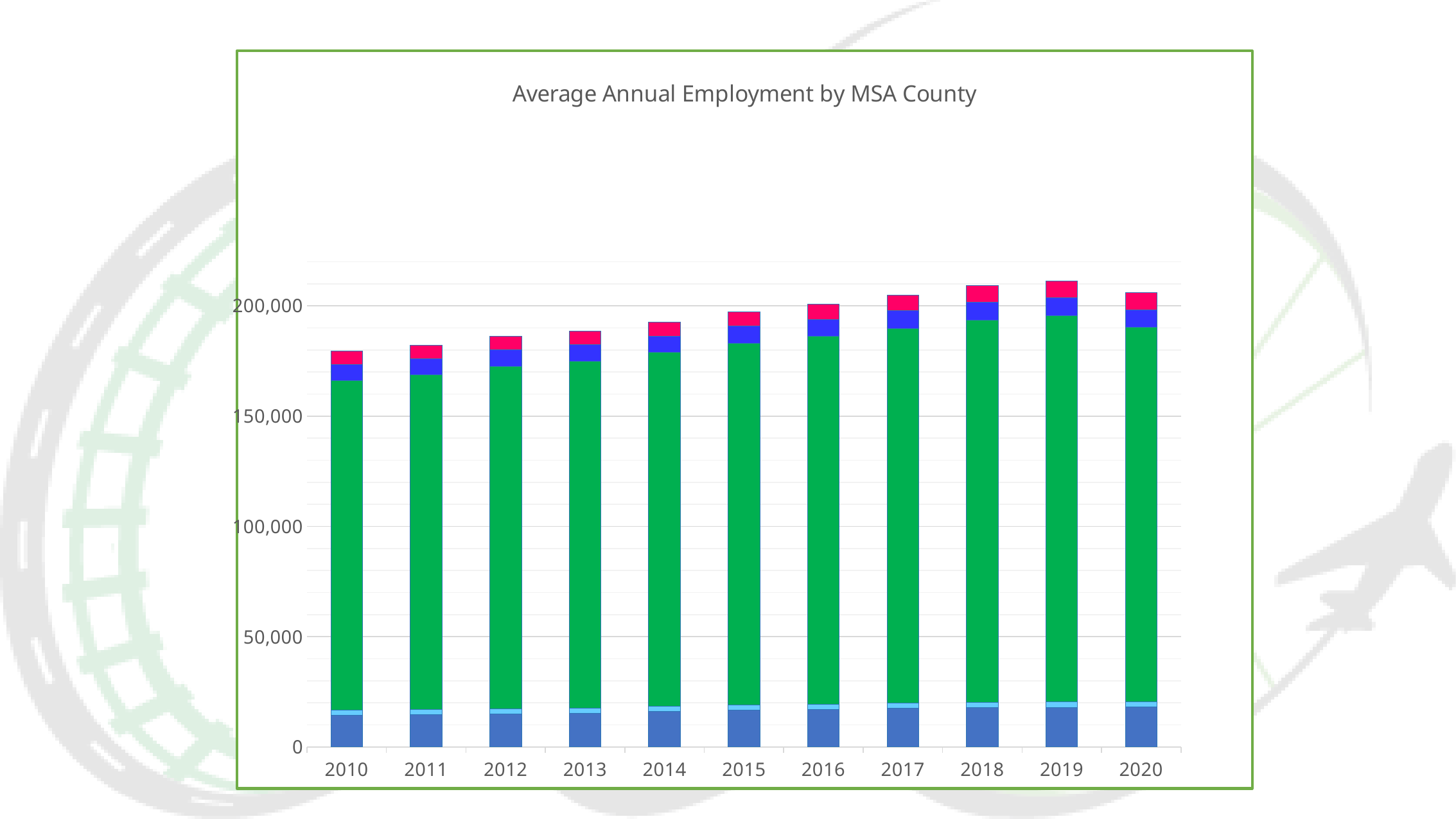
How many years are shown on the x axis of the chart? 11 What kind of chart is shown on the slide? Stacked bar chart Is the total value for 2013 greater or less than 200,000? less What is the title of the chart? Average Annual Employment by MSA County Which year has the tallest stacked bar? 2019 Do the total bar heights generally rise or fall from 2010 to 2019? rise Is the total value for 2010 greater or less than 200,000? less Which year has a larger total, 2013 or 2018? 2018 Which year has the shortest stacked bar? 2010 Is the total value for 2019 greater or less than 200,000? greater Which year has a larger total, 2010 or 2019? 2019